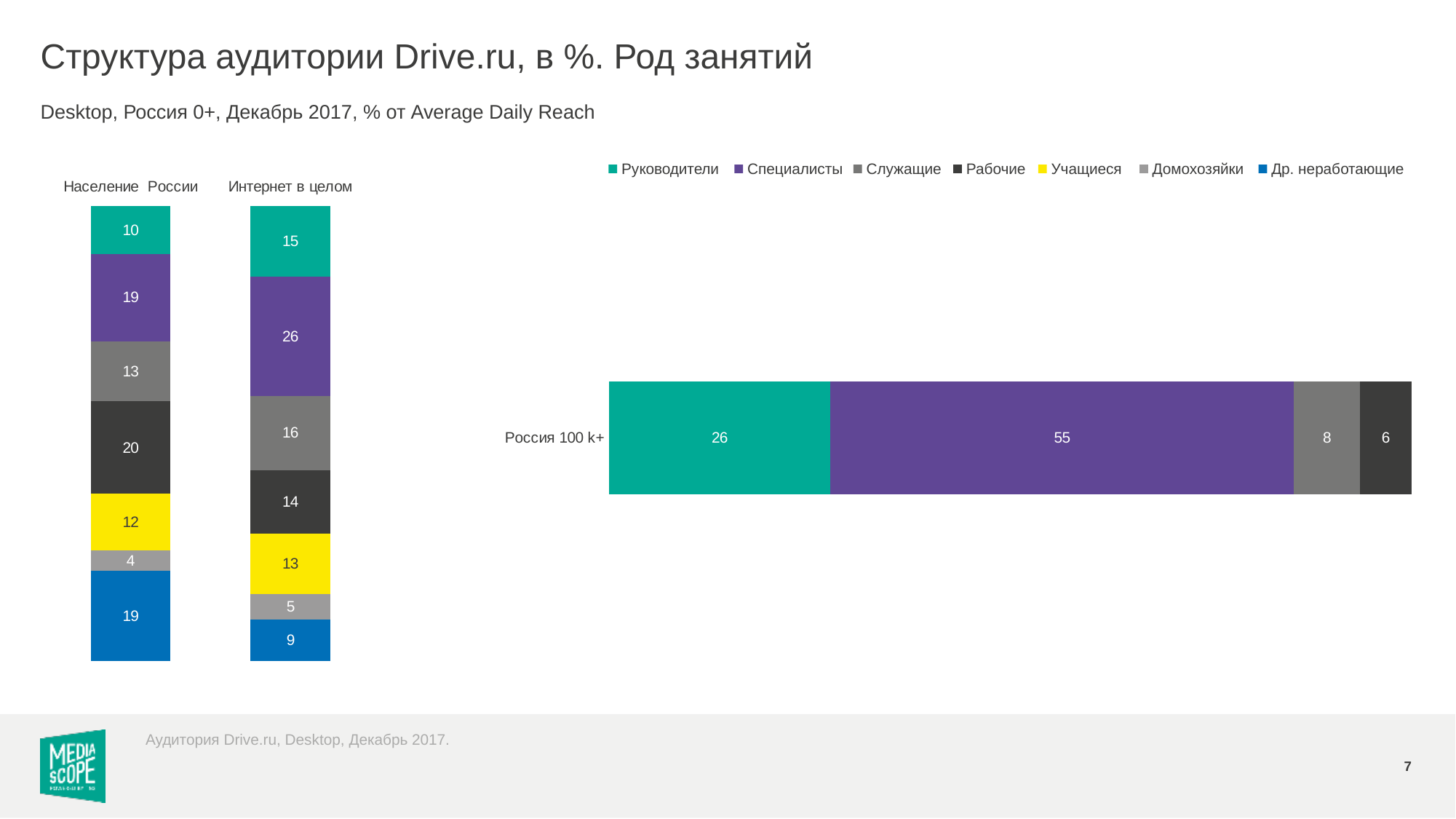
In the "Интернет в целом" chart, what is the difference between Служащие and Рабочие? 2 In the "Россия 100 k+" chart on the right, what is the difference between Специалисты and Руководители? 29 In the "Интернет в целом" chart, which occupation group has the highest value? Специалисты In the "Россия 100 k+" chart on the right, what is the value for Специалисты? 55 In the "Россия 100 k+" chart on the right, what is the value for Рабочие? 6 In the "Население России" chart, which is larger: Рабочие or Учащиеся? Рабочие Which colour represents Учащиеся in the legend? Yellow How many series does the legend list? 7 In the "Интернет в целом" chart, what is the value for Руководители? 15 In the "Население России" chart, which occupation group has the lowest value? Домохозяйки In the "Население России" chart, what is the value for Специалисты? 19 What kind of chart is the "Россия 100 k+" chart on the right? Stacked bar chart